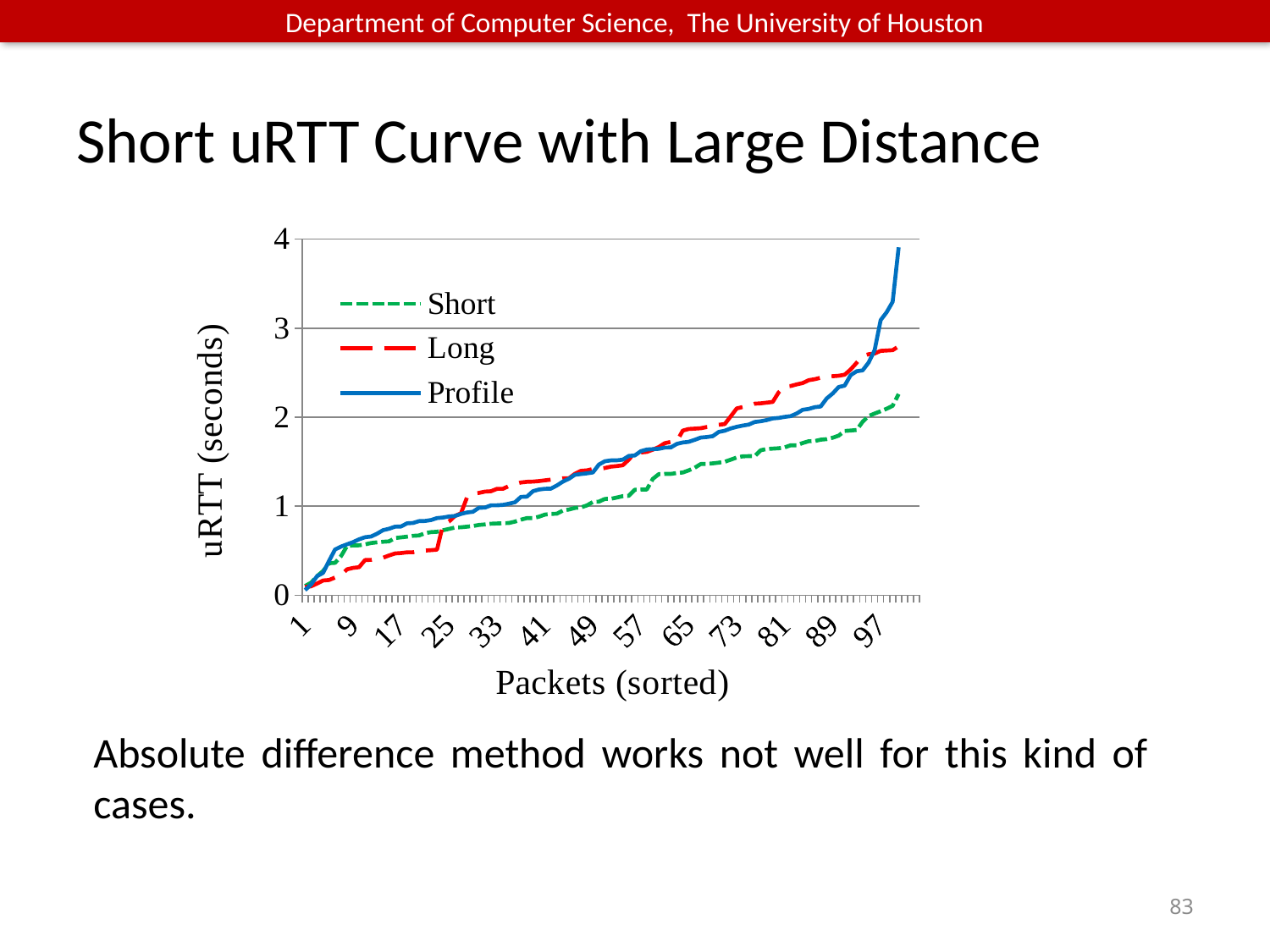
Is the value of the Long series at packet 9 greater or less than 1? less Do the values of the Profile series rise or fall along the x axis? rise How many series does the legend list? 3 Which series reaches the highest value at the right end of the chart? Profile What kind of chart is shown on the slide? line chart At packet 97, which series is higher, Short or Long? Long Is the value of the Profile series at the last packet greater or less than 3? greater Is the value of the Short series at packet 97 greater or less than 3? less What are the series names listed in the legend? Short, Long, Profile What is the title of the y axis? uRTT (seconds) Which series has the lowest values over the right half of the chart? Short